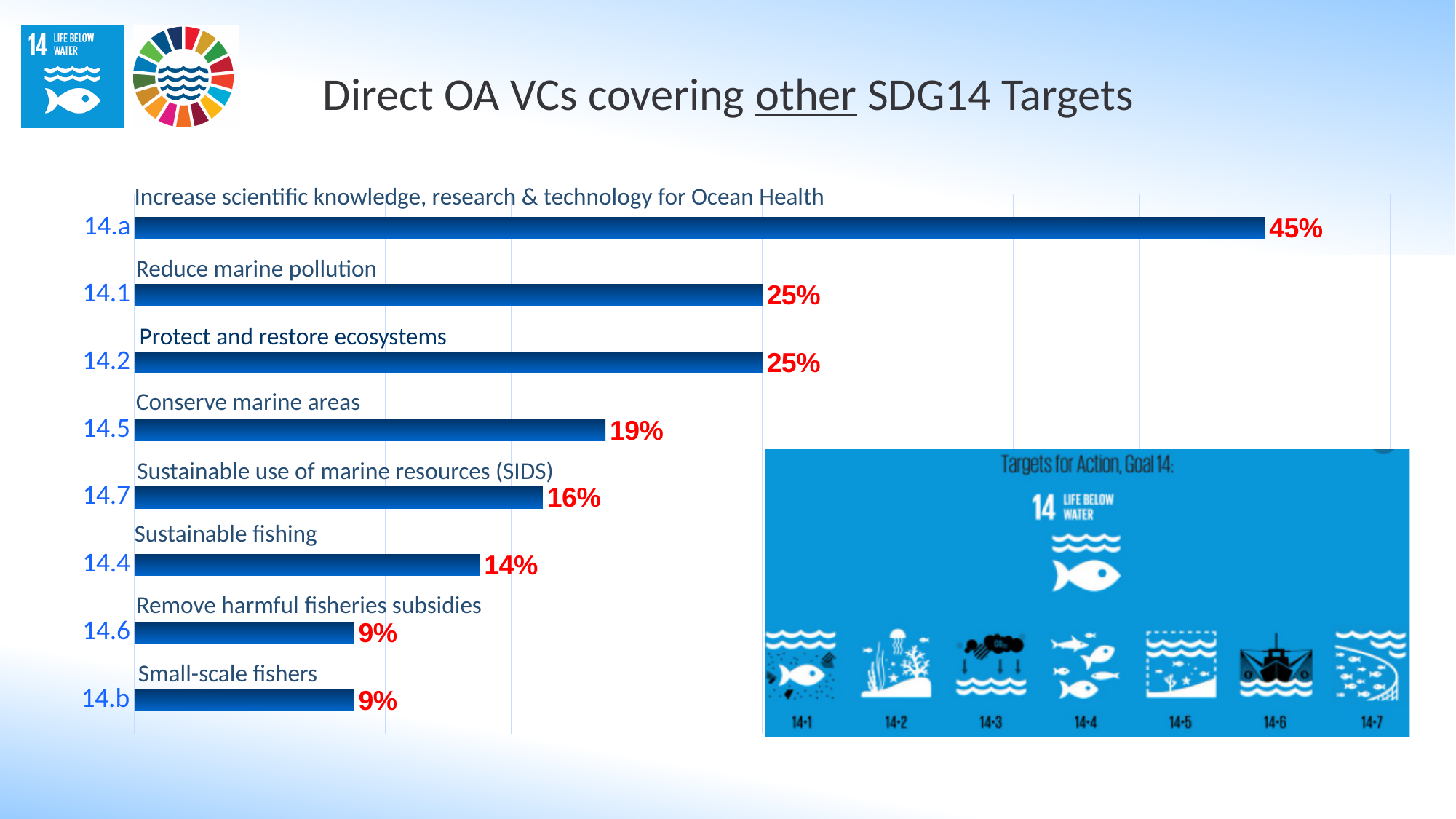
What is the value for target 14.4 (Sustainable fishing)? 14% What is the value for target 14.a? 45% Which target has the highest value? 14.a What is the value for target 14.7 (Sustainable use of marine resources (SIDS))? 16% Which is larger, the value for 14.7 or the value for 14.6? 14.7 What is the difference between the values for 14.5 and 14.4? 5% What is the difference between the values for 14.a and 14.1? 20% How many targets are plotted in the bar chart? 8 What kind of chart is shown on the slide? Bar chart What is the title of the slide's chart? Direct OA VCs covering other SDG14 Targets What is the value for target 14.5 (Conserve marine areas)? 19% Which target is labelled 'Reduce marine pollution'? 14.1